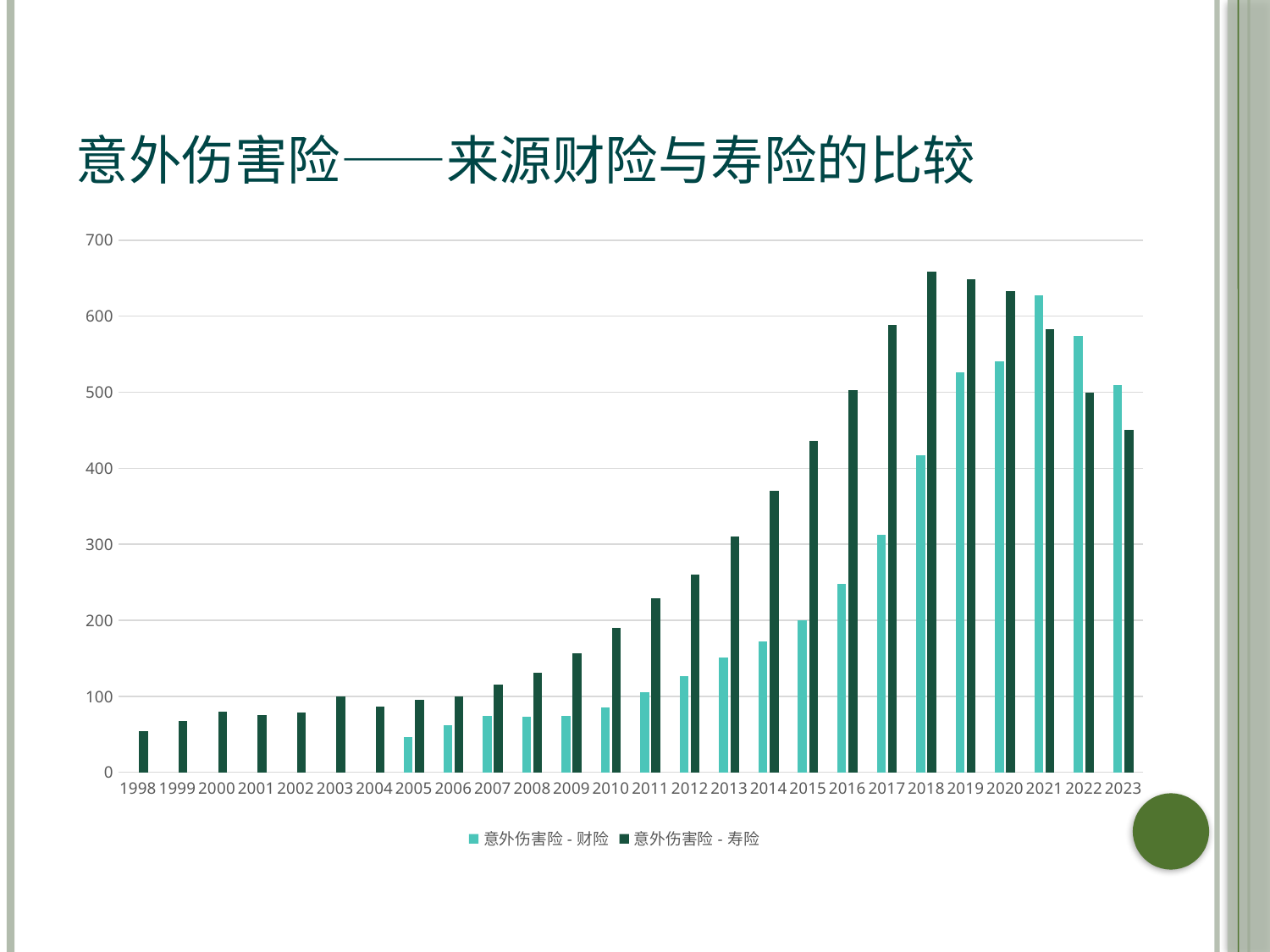
In which year is the value for 意外伤害险 - 寿险 the lowest? 1998 How many years are shown on the x axis? 26 In 2021, which series has the larger value, 意外伤害险 - 财险 or 意外伤害险 - 寿险? 意外伤害险 - 财险 Does the value for 意外伤害险 - 寿险 rise or fall from 2018 to 2023? Fall What kind of chart is shown on the slide? Bar chart Is the value for 意外伤害险 - 寿险 in 2023 greater or less than 500? less In 2018, which series has the larger value, 意外伤害险 - 财险 or 意外伤害险 - 寿险? 意外伤害险 - 寿险 In which year is the value for 意外伤害险 - 寿险 the highest? 2018 How many series does the legend list? 2 Is the value for 意外伤害险 - 寿险 in 2018 greater or less than 600? greater Is the value for 意外伤害险 - 财险 in 2005 greater or less than 100? less In which year is the value for 意外伤害险 - 财险 the highest? 2021